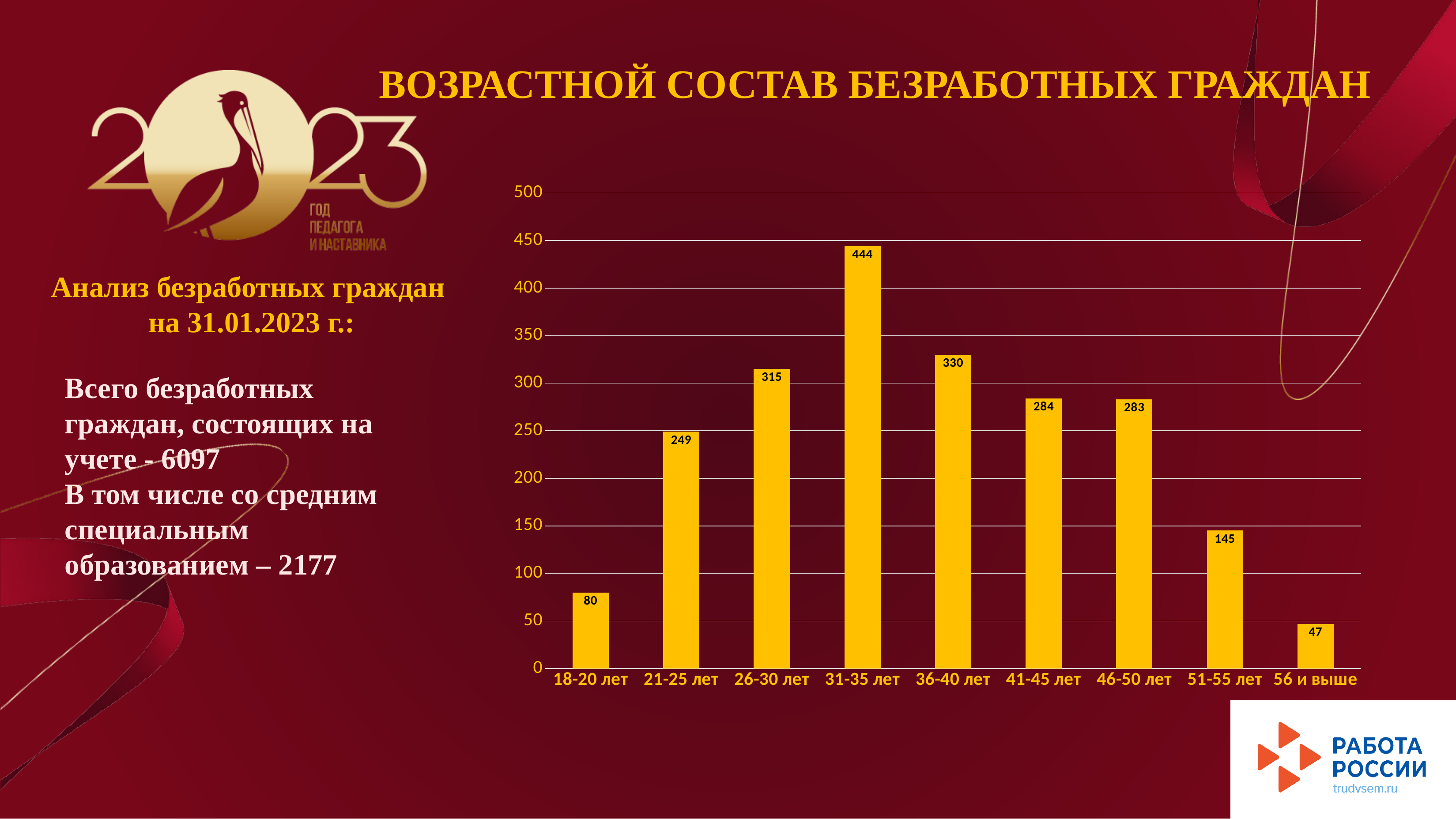
Which age group has the highest value? 31-35 лет What is the value for the 51-55 лет age group? 145 What is the value for the 31-35 лет age group? 444 Which is larger, the value for 36-40 лет or the value for 26-30 лет? 36-40 лет What is the difference between the values for 31-35 лет and 36-40 лет? 114 Which age group has the lowest value? 56 и выше What is the title of the chart? ВОЗРАСТНОЙ СОСТАВ БЕЗРАБОТНЫХ ГРАЖДАН What kind of chart is shown on the slide? bar chart Is the value for 46-50 лет greater or less than 250? greater What is the value for the 18-20 лет age group? 80 How many age groups are shown on the chart? 9 What is the difference between the values for 26-30 лет and 21-25 лет? 66